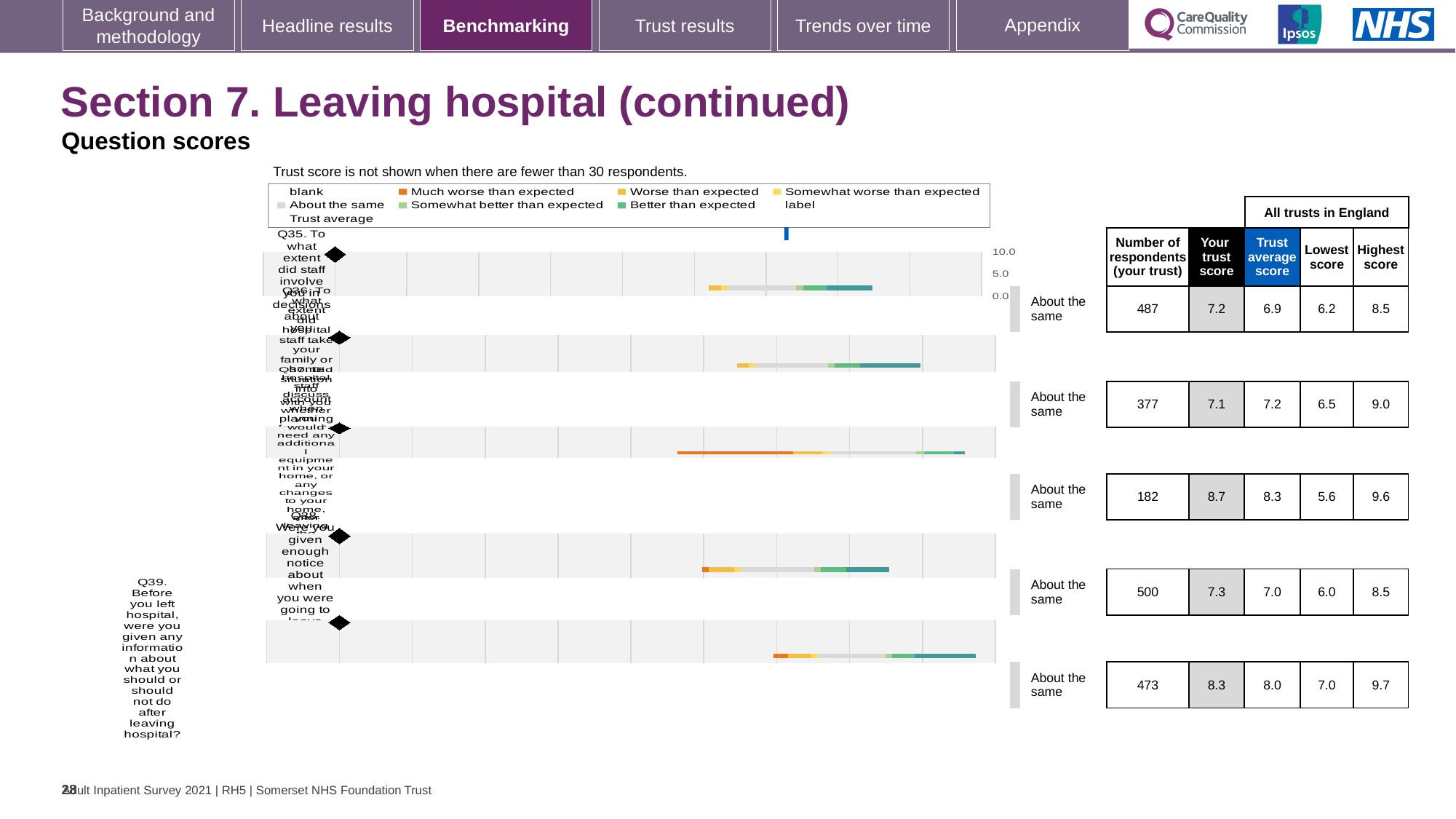
What is the highest score across all trusts in England for Q39? 9.7 What kind of chart is shown on the slide? Bar chart What is the trust score for Q39 (information about what you should or should not do after leaving hospital)? 8.3 For the first row (Q35), which is larger: the trust score or the trust average score? The trust score (7.2) Is the trust score marker for Q39 greater or less than 5.0 on the axis? greater What is the difference between the trust score and the trust average score for Q39? 0.3 What benchmark category is shown for every question on this slide? About the same How many respondents answered Q39 at this trust? 473 How many questions (rows) are plotted in the chart? 5 What is the trust average score for Q39? 8.0 Which row has the lowest 'Your trust score' value? The second row (Q36), 7.1 Which row has the highest 'Your trust score' value? The third row (Q37), 8.7